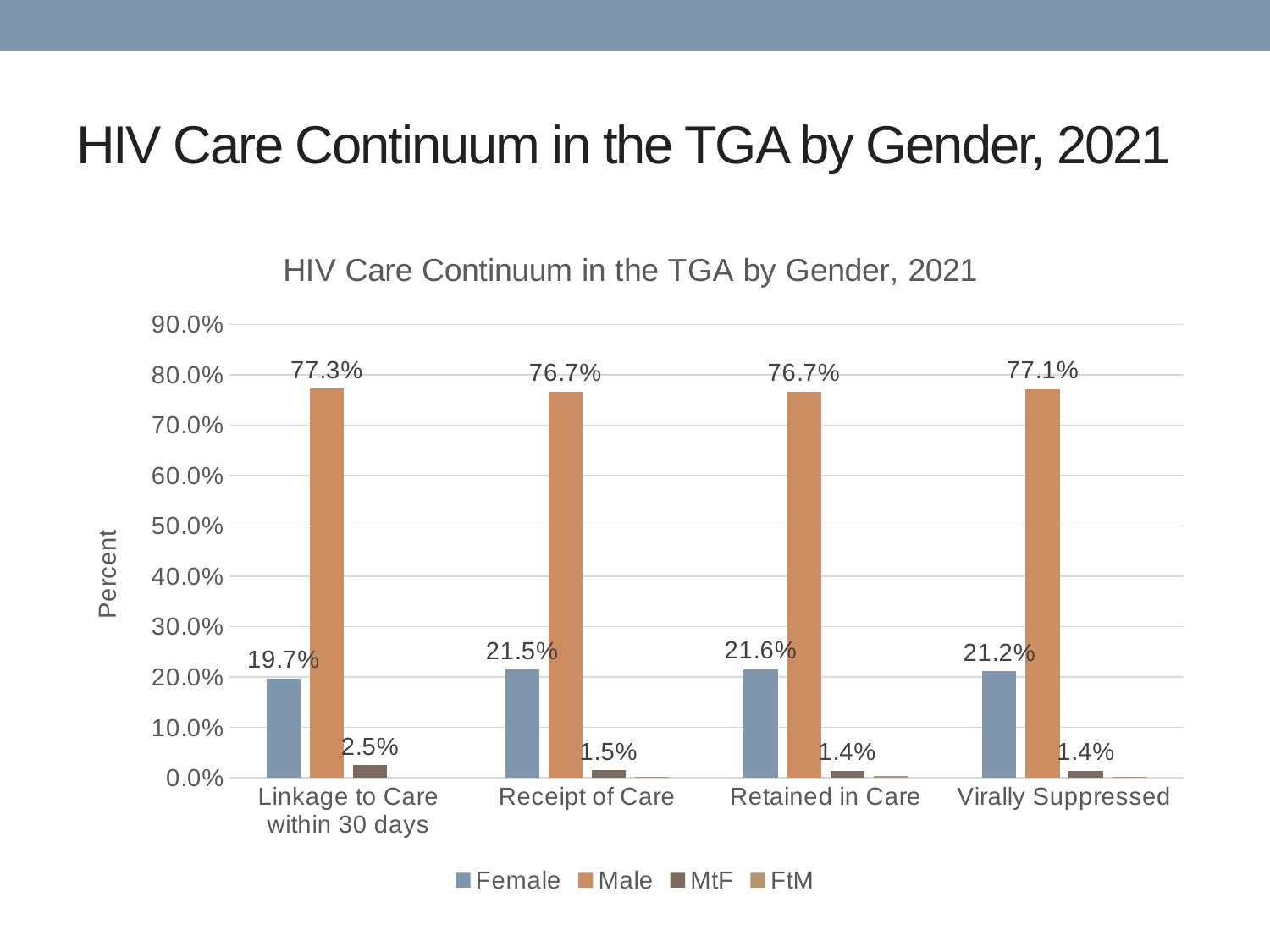
What is the value for Male in the Linkage to Care within 30 days category? 77.3% In which category is the Female value lowest? Linkage to Care within 30 days In which category is the MtF value highest? Linkage to Care within 30 days Which is larger in the Receipt of Care category, the Female value or the MtF value? Female What is the value for MtF in the Receipt of Care category? 1.5% What is the difference between the Male and Female values in the Linkage to Care within 30 days category? 57.6% What is the value for Female in the Virally Suppressed category? 21.2% How many series does the legend list? 4 How many categories are shown on the x axis? 4 What is the value for Female in the Retained in Care category? 21.6% What kind of chart is shown on the slide? Bar chart Is the Female value for Receipt of Care greater or less than 20.0%? greater